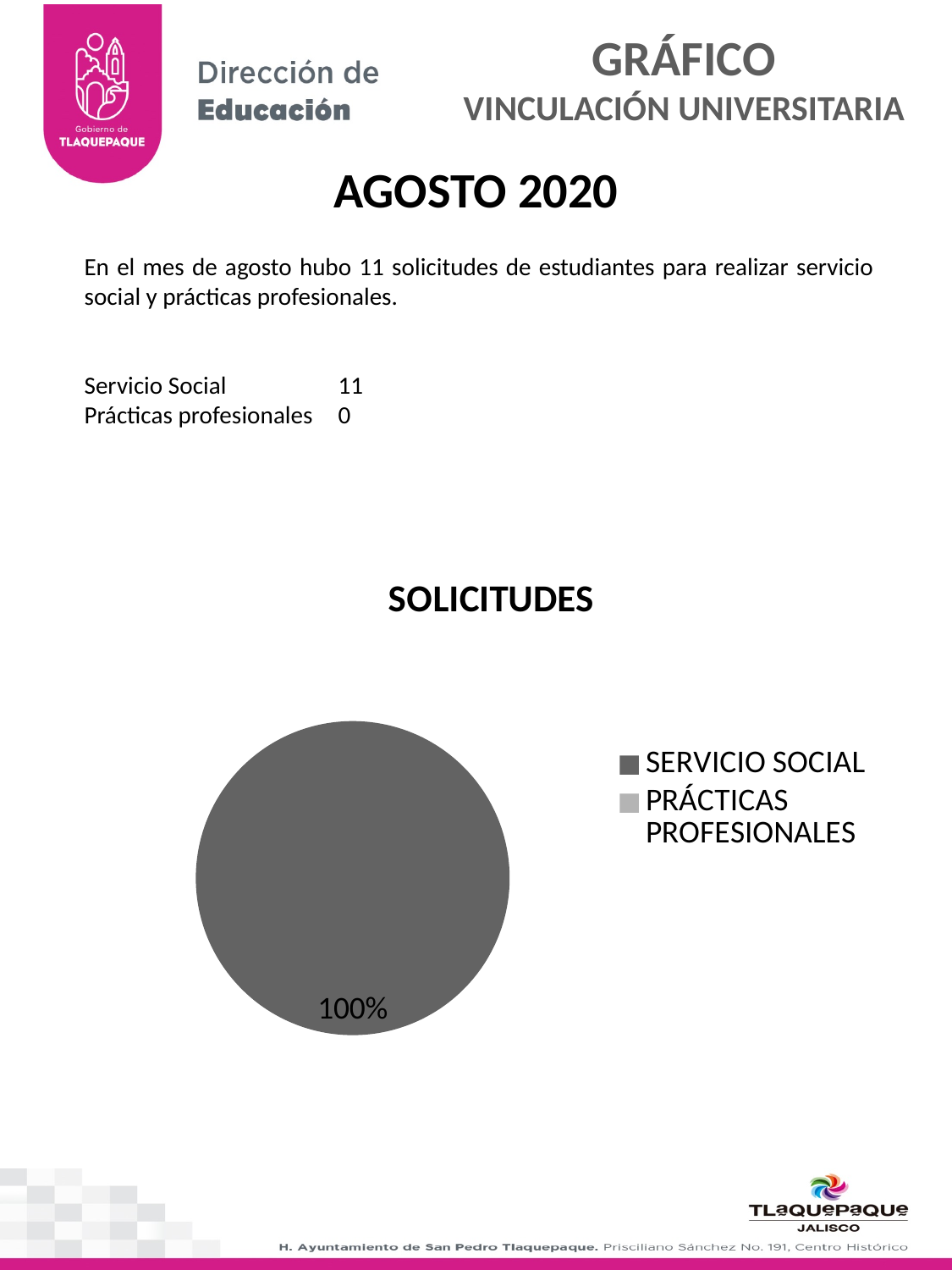
What share of the pie does SERVICIO SOCIAL take? 100% What kind of chart is shown under the title SOLICITUDES? pie chart What is the title of the chart? SOLICITUDES Which category takes the largest share of the pie? SERVICIO SOCIAL What percentage label is printed on the pie slice? 100% How many visible slices does the pie chart have? 1 How many entries does the chart legend list? 2 Which is larger in the pie chart, SERVICIO SOCIAL or PRÁCTICAS PROFESIONALES? SERVICIO SOCIAL Which category takes the smallest share of the pie? PRÁCTICAS PROFESIONALES Which legend entry is shown in dark grey? SERVICIO SOCIAL